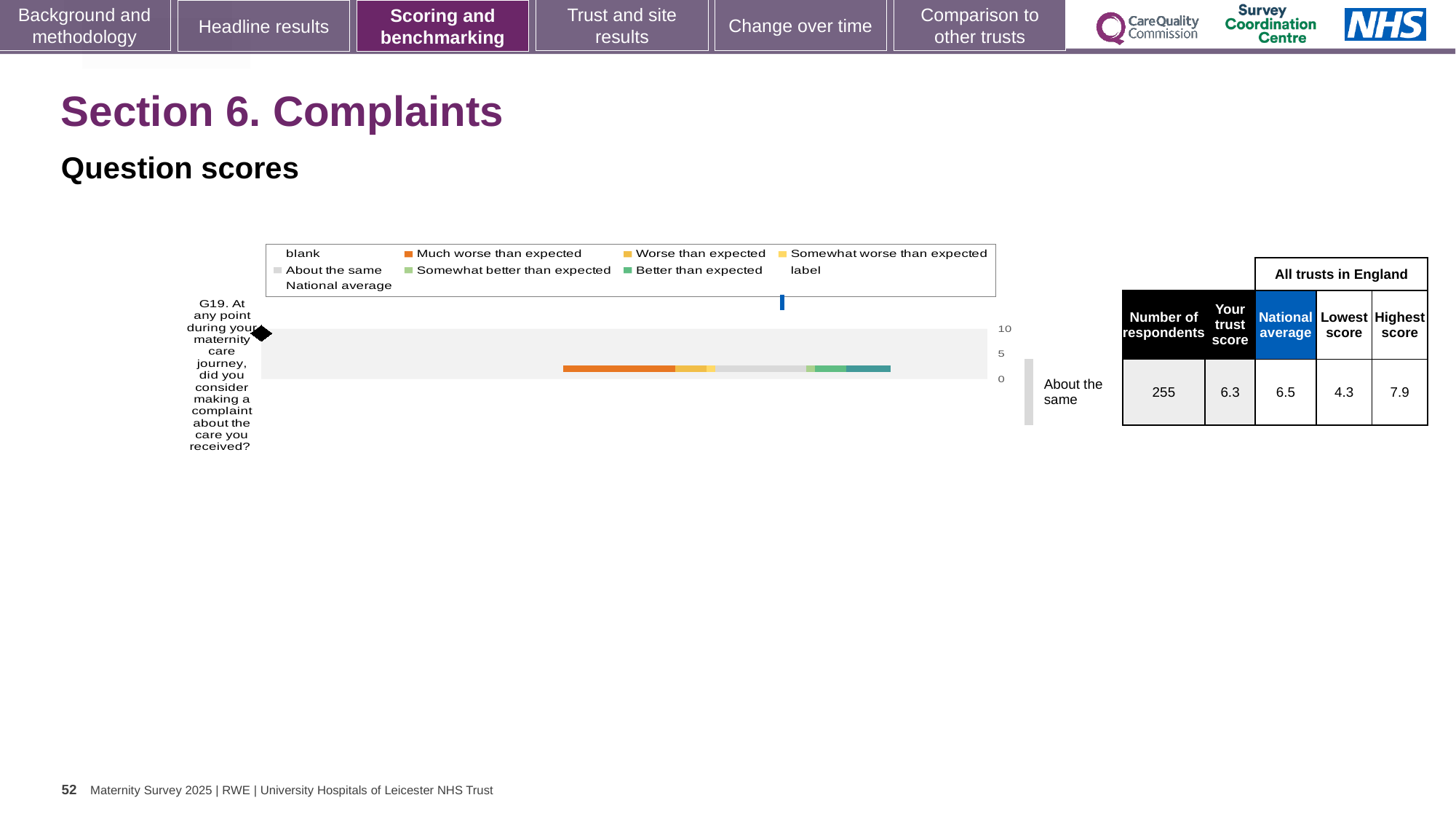
What is the difference between the highest score (7.9) and the lowest score (4.3) for G19? 3.6 What is the trust score for G19 shown in the table beside the chart? 6.3 What colour represents 'Much worse than expected' in the chart legend? orange How many survey questions are plotted in the chart? 1 How many respondents answered G19 according to the table beside the chart? 255 What is the national average for G19 shown in the table beside the chart? 6.5 Which question number is plotted in the chart? G19 What is the highest score among all trusts in England for G19? 7.9 What kind of chart is shown on the slide? bar chart Which is larger for G19: the trust score or the national average? National average What benchmark category is the trust's G19 result labelled as next to the chart? About the same